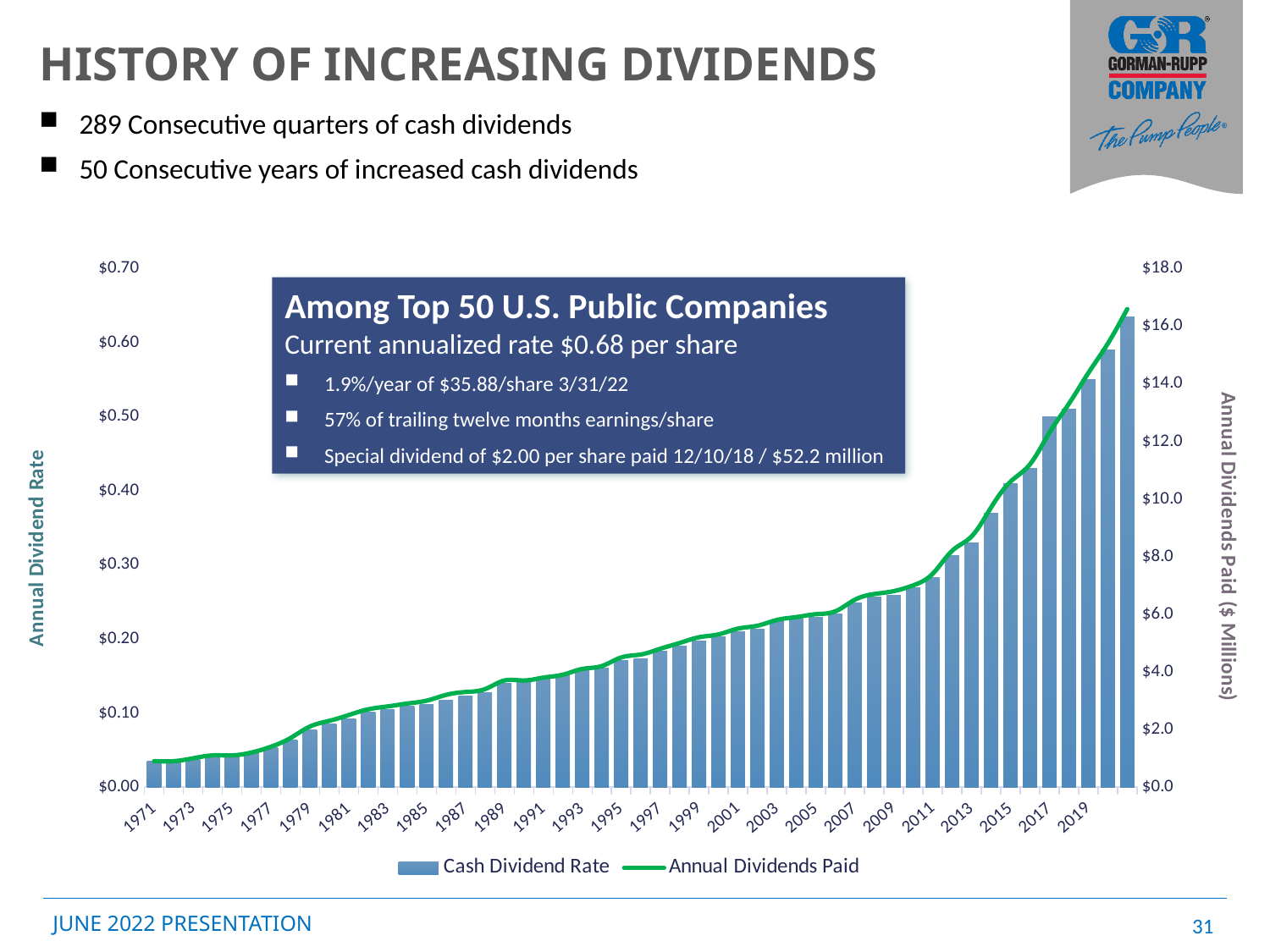
Is the Cash Dividend Rate for 1991 greater or less than $0.10? greater Which year has the larger Cash Dividend Rate, 1991 or 2001? 2001 Do the Cash Dividend Rate bars generally rise or fall from 1971 to the right end of the x axis? Rise Is the Annual Dividends Paid value for 2009 greater or less than $6.0 million? greater What are the two series named in the chart legend? Cash Dividend Rate and Annual Dividends Paid Is the Cash Dividend Rate for 2013 greater or less than $0.30? greater What kind of chart is shown on the slide? Combined bar and line chart What is the title of the right-hand vertical axis? Annual Dividends Paid ($ Millions) How many series does the chart legend list? 2